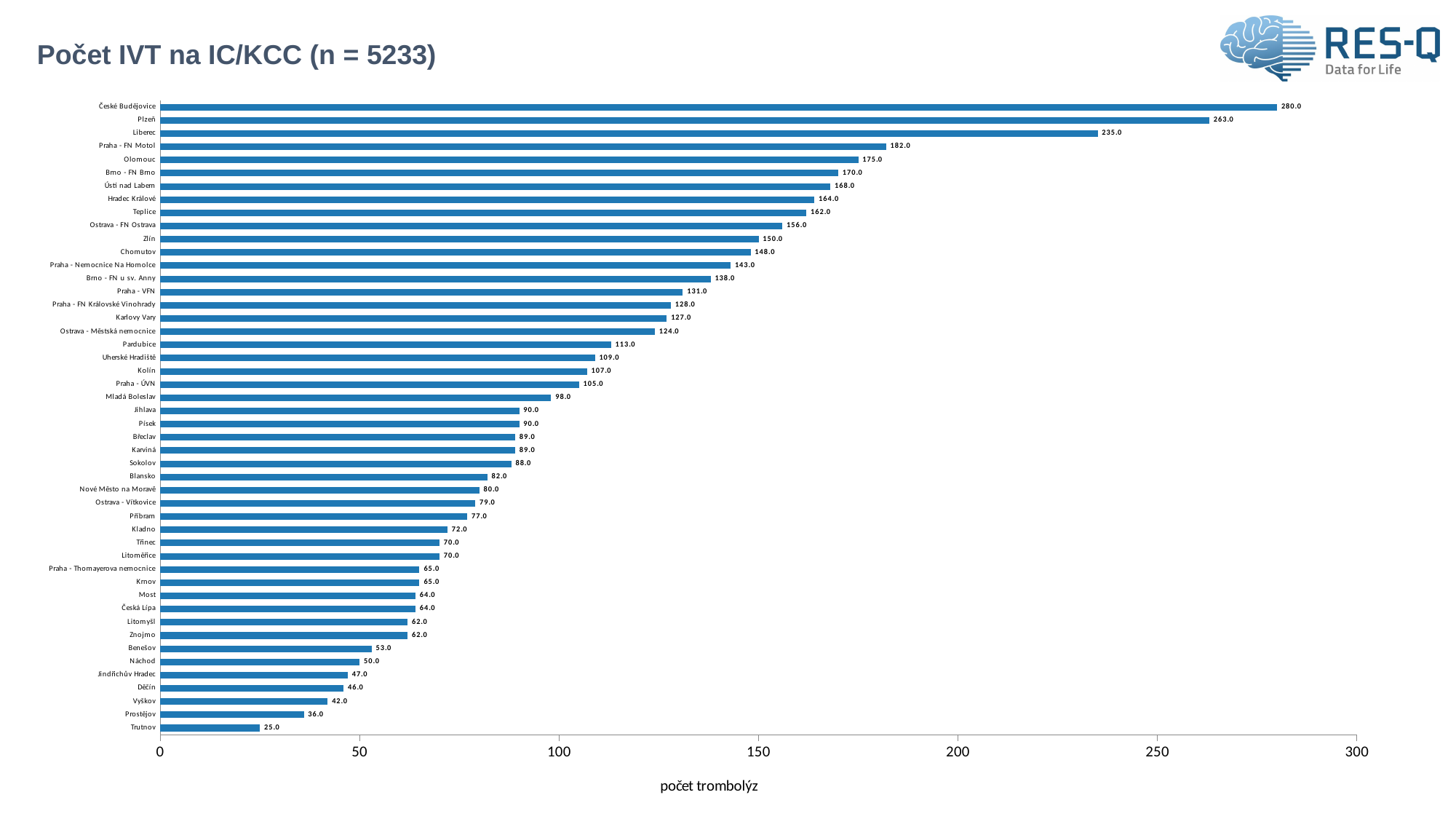
What is the difference between the values for Plzeň and Liberec? 28.0 What is the value for Karlovy Vary? 127.0 Is the value for Pardubice greater or less than 100? greater What kind of chart is shown on the slide? bar chart What is the value for České Budějovice? 280.0 What is the value for Praha - FN Motol? 182.0 How many categories are shown in the chart? 48 Which category has the lowest value? Trutnov What is the title of the chart? Počet IVT na IC/KCC (n = 5233) Which has a larger value, Olomouc or Zlín? Olomouc Which category has the highest value? České Budějovice What is the label of the horizontal axis? počet trombolýz